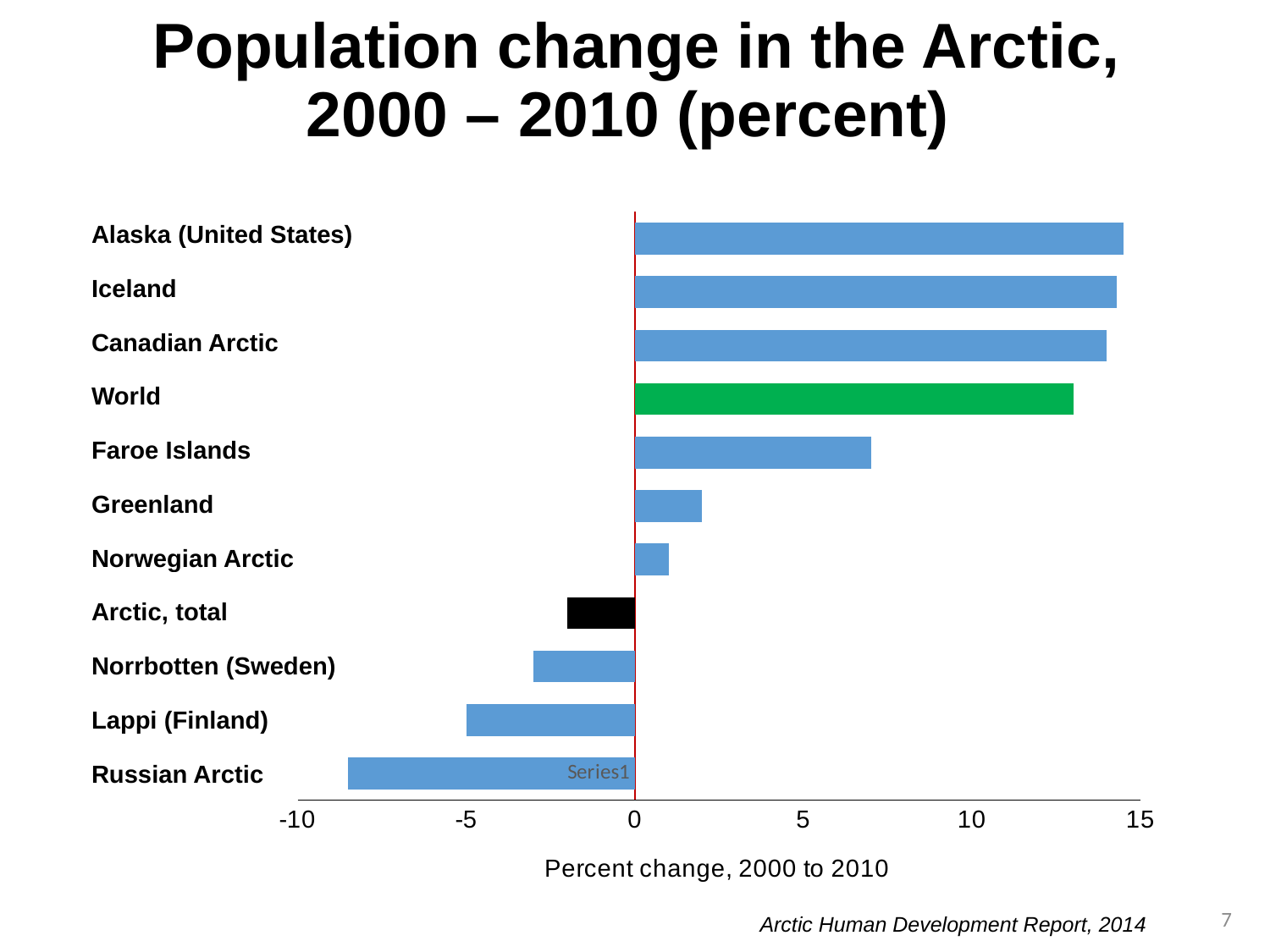
Is the value for Greenland greater or less than 5? less Which region has the lowest population change in the chart? Russian Arctic Which has the larger population change, Faroe Islands or Greenland? Faroe Islands Is the value for Russian Arctic greater or less than -5? less Which has the larger population change, World or Faroe Islands? World What kind of chart is shown on the slide? bar chart Is the value for Norrbotten (Sweden) greater or less than -5? greater Which category's bar is coloured green? World How many categories (regions) are plotted in the chart? 11 What is the title of the chart? Population change in the Arctic, 2000 – 2010 (percent)